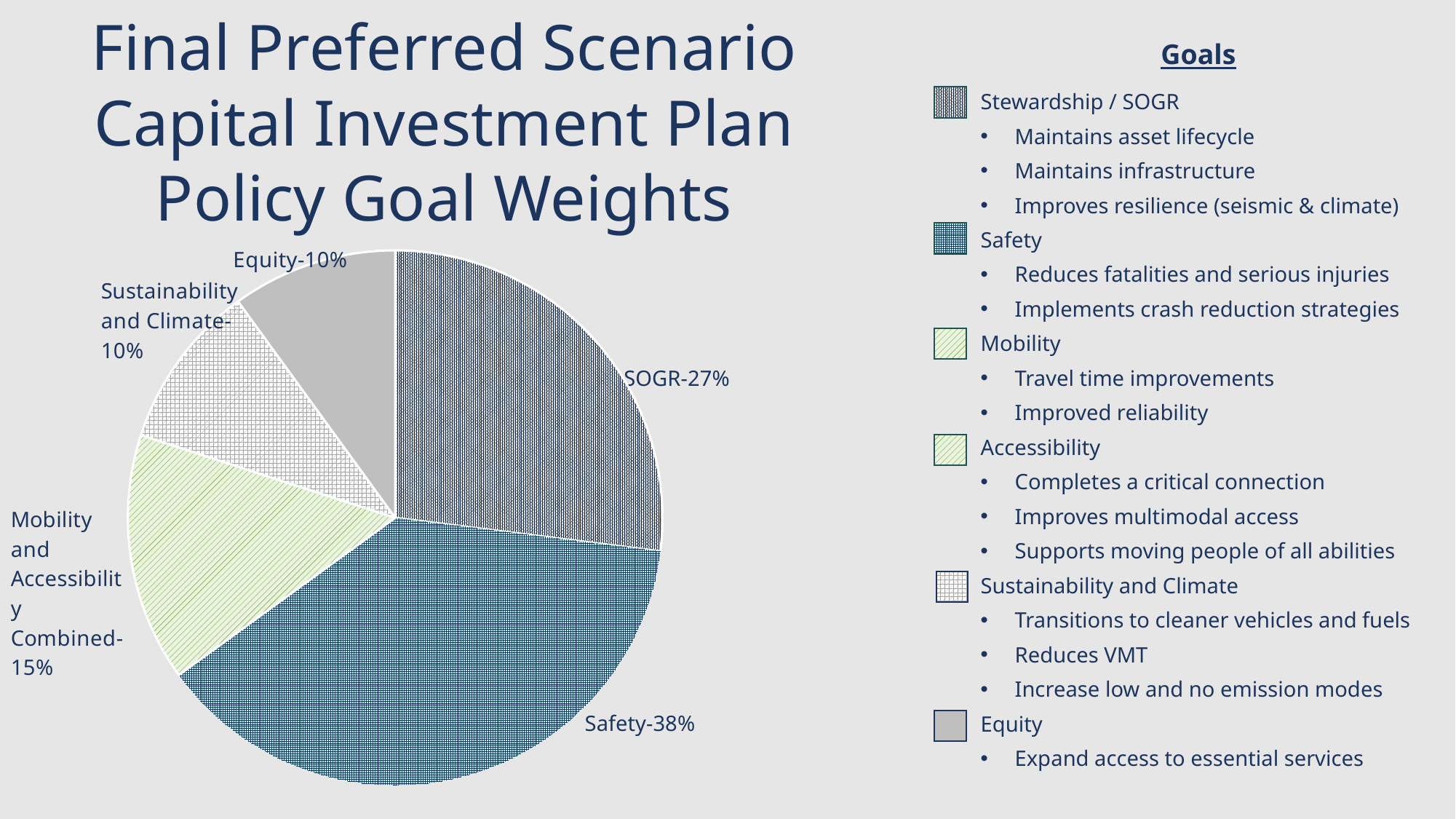
Which slice of the pie chart is the largest? Safety What is the title of the slide containing the pie chart? Final Preferred Scenario Capital Investment Plan Policy Goal Weights What kind of chart is shown on the slide? pie chart What is the weight for SOGR in the pie chart? 27% What is the weight for Equity in the pie chart? 10% How many slices does the pie chart have? 5 What is the difference between the Safety weight and the SOGR weight? 11% What is the weight for Safety in the pie chart? 38% Which slice of the pie chart is shown in solid grey? Equity Which is larger, the weight for SOGR or the weight for Mobility and Accessibility Combined? SOGR What is the combined weight of Sustainability and Climate and Equity? 20% What is the weight for Mobility and Accessibility Combined? 15%